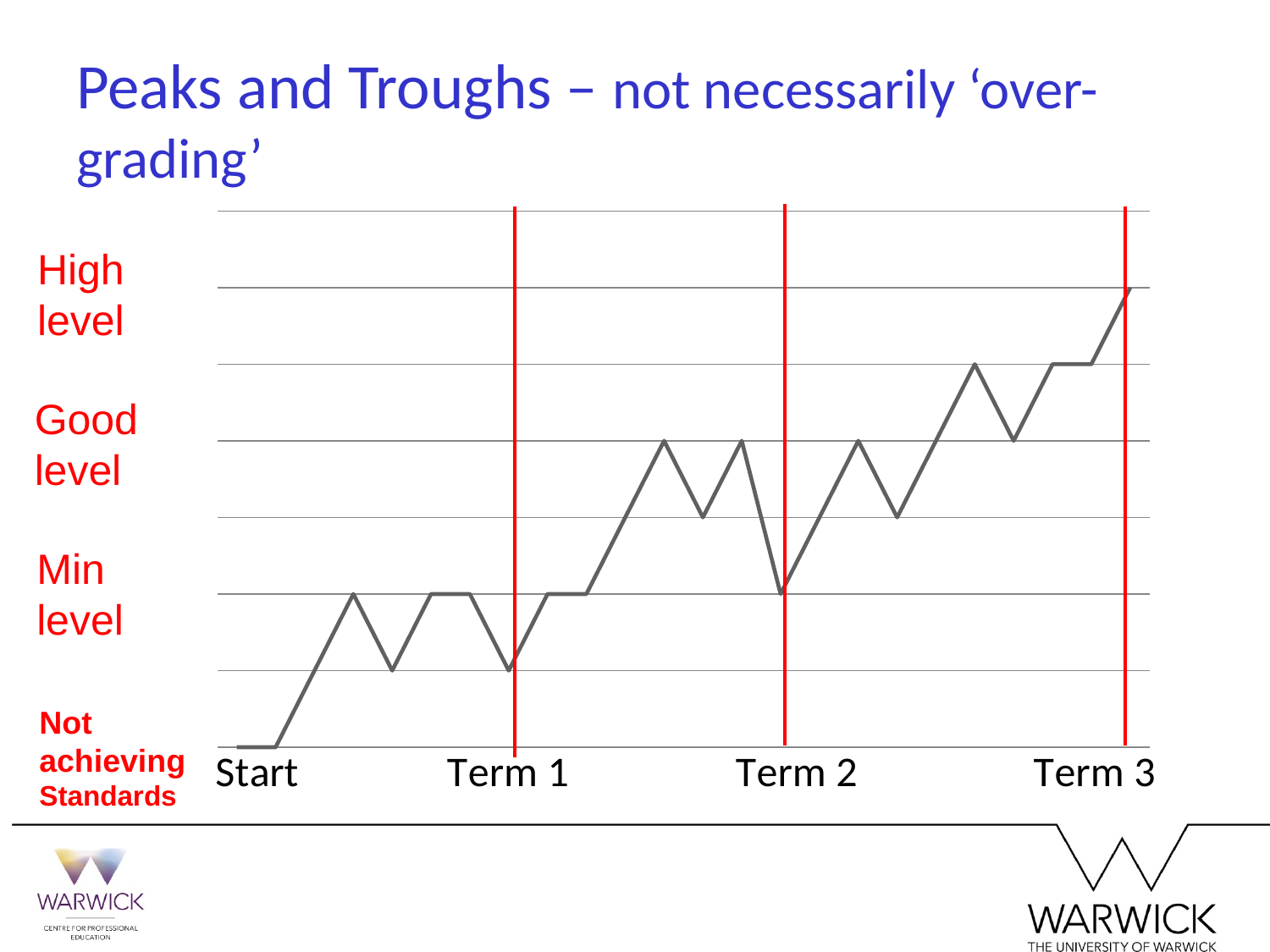
How many red vertical lines are drawn on the chart? 3 What is the lowest level labelled on the y axis? Not achieving Standards At which x-axis label is the line at its lowest point? Start How many labels are shown on the x axis? 4 At which x-axis label does the line reach its highest point? Term 3 Is the line higher at Term 3 or at Start? Term 3 What kind of chart is shown on the slide? Line chart What is the highest level labelled on the y axis? High level What is the title of the slide containing the chart? Peaks and Troughs – not necessarily 'over-grading' Is the line higher at Term 1 or at Term 2? Term 2 Overall, does the line rise or fall from Start to Term 3? Rises Is the line higher at Term 2 or at Term 3? Term 3